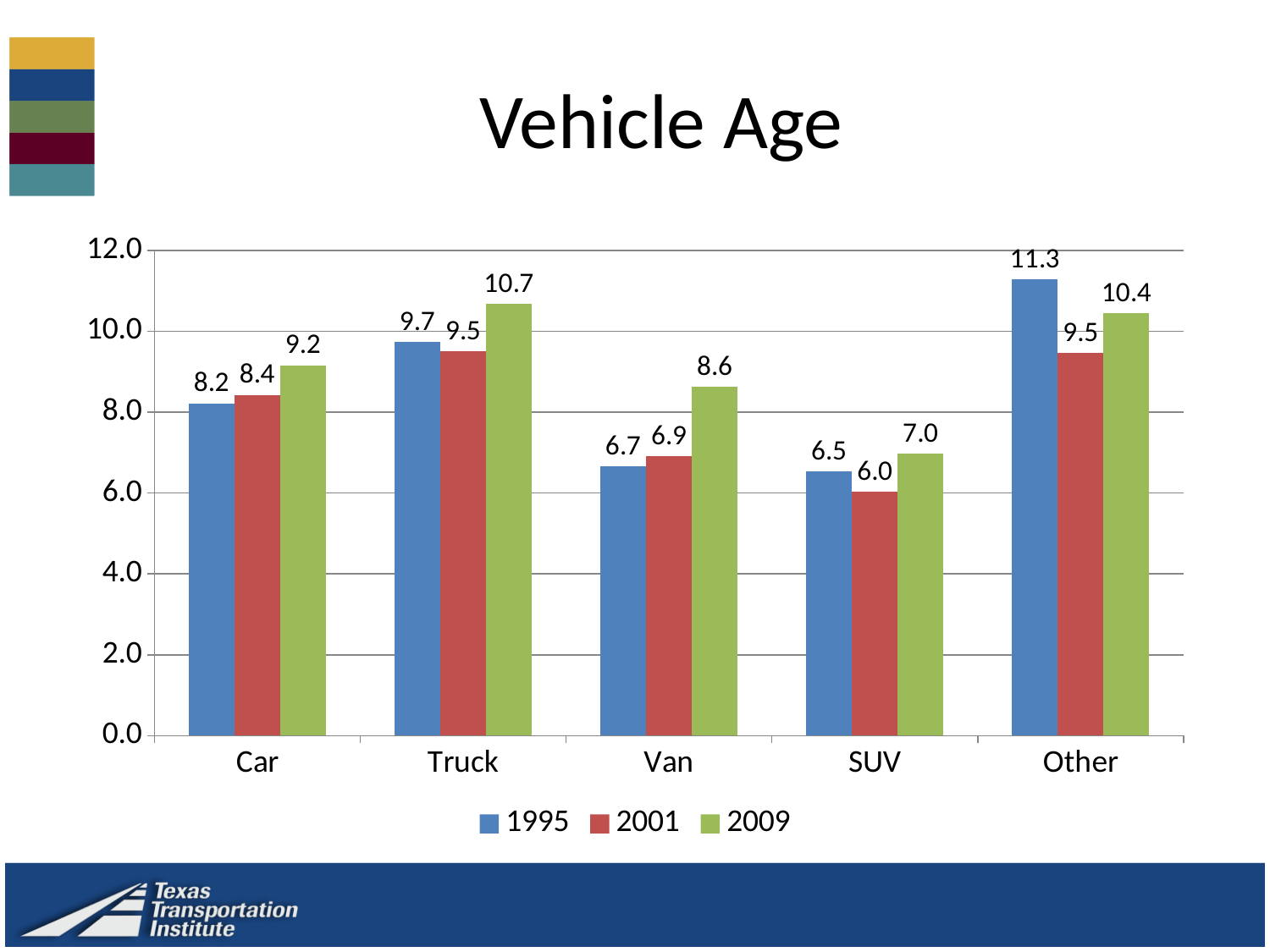
Which category has the lowest value in the 1995 series? SUV Is the 2009 value for Other greater or less than 10.0? greater How many series does the legend list? 3 Which is larger for Truck: the 1995 value or the 2001 value? 1995 What is the value for Other in the 1995 series? 11.3 What kind of chart is shown on the slide? bar chart What is the value for Car in the 2009 series? 9.2 Which category has the highest value in the 2009 series? Truck What is the value for SUV in the 2001 series? 6.0 What is the difference between the 2009 and 1995 values for Van? 1.9 How many vehicle categories are shown on the x axis? 5 What is the title of the chart? Vehicle Age